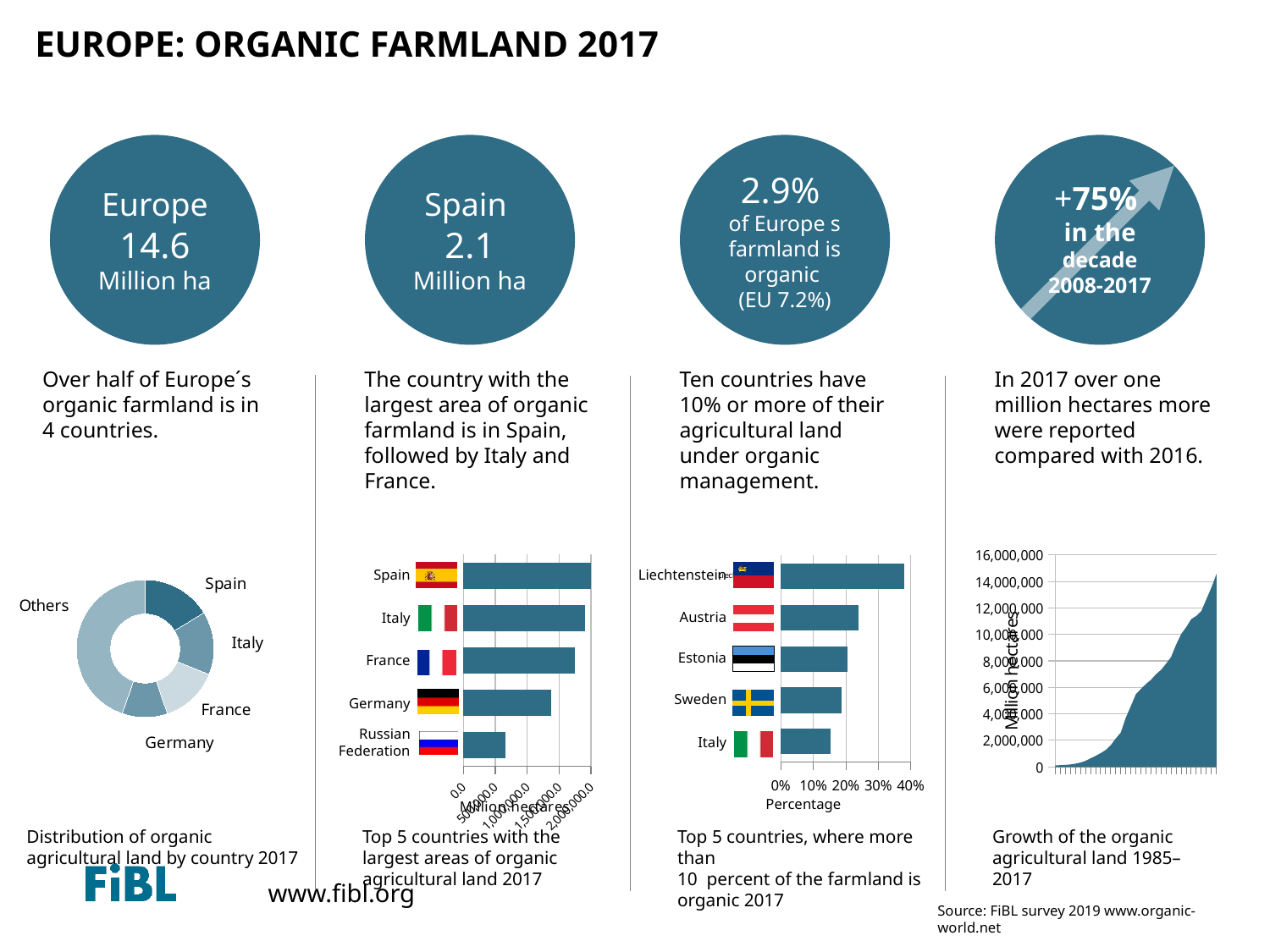
In the 'Top 5 countries with the largest areas of organic agricultural land 2017' chart, which country has the lowest value? Russian Federation What kind of chart is the 'Growth of the organic agricultural land 1985–2017' chart? area chart In the 'Top 5 countries with the largest areas of organic agricultural land 2017' chart, is the value for the Russian Federation greater or less than 1,000,000? less In the 'Top 5 countries, where more than 10 percent of the farmland is organic 2017' chart, which country has the highest percentage? Liechtenstein What kind of chart is the 'Top 5 countries with the largest areas of organic agricultural land 2017' chart? bar chart In the 'Top 5 countries, where more than 10 percent of the farmland is organic 2017' chart, which is larger, Austria or Italy? Austria In the 'Growth of the organic agricultural land 1985–2017' chart, do the values rise or fall over time? rise What kind of chart is the 'Distribution of organic agricultural land by country 2017' chart? doughnut chart In the 'Top 5 countries, where more than 10 percent of the farmland is organic 2017' chart, is the value for Liechtenstein greater or less than 30%? greater In the 'Top 5 countries, where more than 10 percent of the farmland is organic 2017' chart, which country has the lowest percentage? Italy In the 'Top 5 countries with the largest areas of organic agricultural land 2017' chart, which country has the highest value? Spain